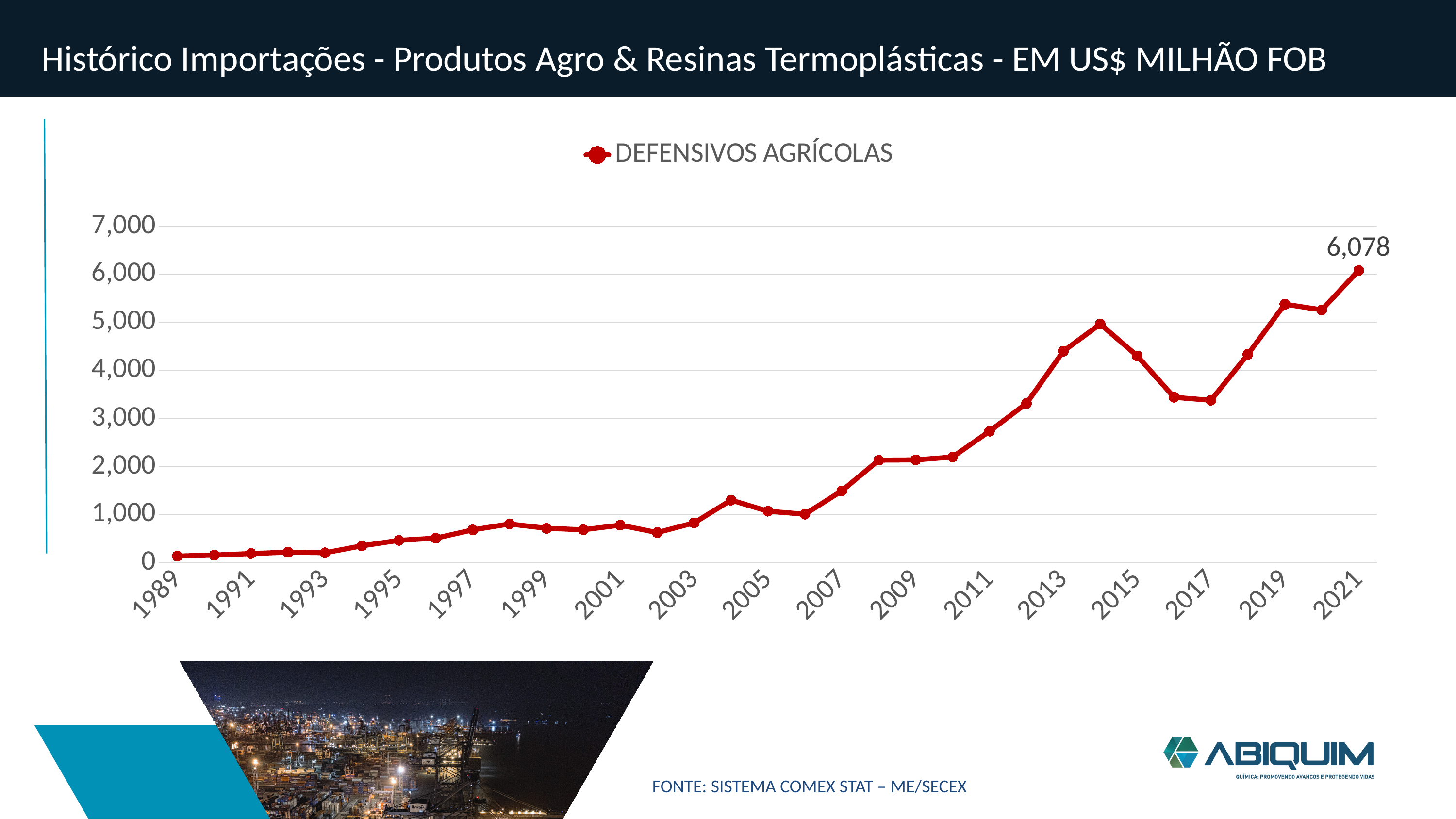
Is the value for 2016 greater or less than 4,000? less Is the value for 2009 greater or less than 3,000? less What is the value for 2021 in the DEFENSIVOS AGRÍCOLAS series? 6,078 Do the values generally rise or fall from 1989 to 2021? rise How many series does the legend list? 1 Which year has the highest value for DEFENSIVOS AGRÍCOLAS? 2021 What kind of chart is shown on the slide? line chart Which is larger, the value for 2014 or the value for 2017? 2014 How many data points are plotted on the line? 33 Is the value for 1999 greater or less than 1,000? less Which is larger, the value for 2004 or the value for 2006? 2004